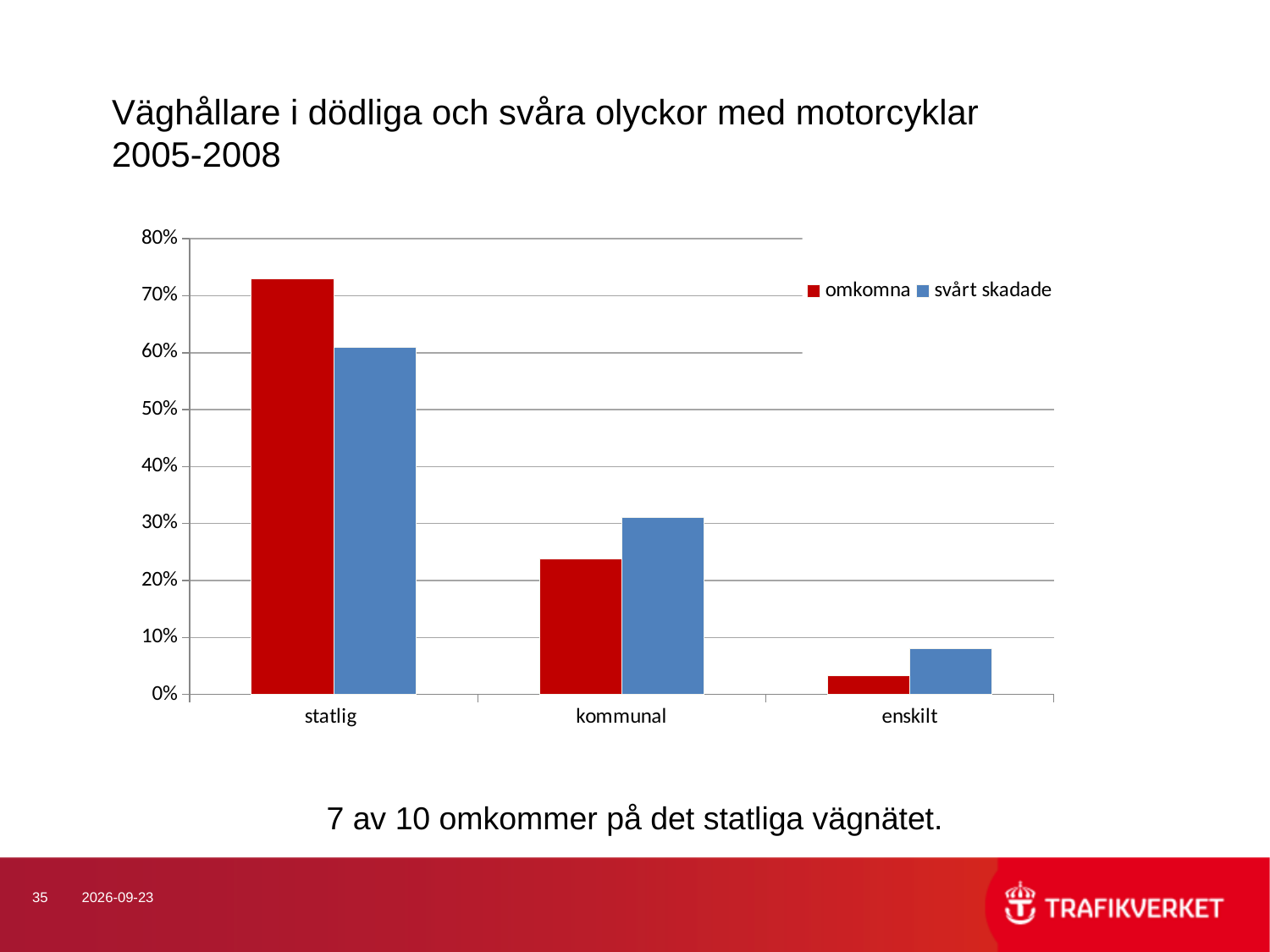
Is the value for omkomna in the statlig category greater or less than 70%? greater How many categories are shown on the x axis of the chart? 3 Which category has the lowest value for svårt skadade? enskilt Which category has the highest value for omkomna? statlig Is the value for svårt skadade in the kommunal category greater or less than 30%? greater Is the value for svårt skadade in the statlig category greater or less than 70%? less What colour are the bars for the omkomna series? red How many series does the chart's legend list? 2 What kind of chart is shown on the slide? bar chart In the kommunal category, which is larger: omkomna or svårt skadade? svårt skadade In the statlig category, which is larger: omkomna or svårt skadade? omkomna